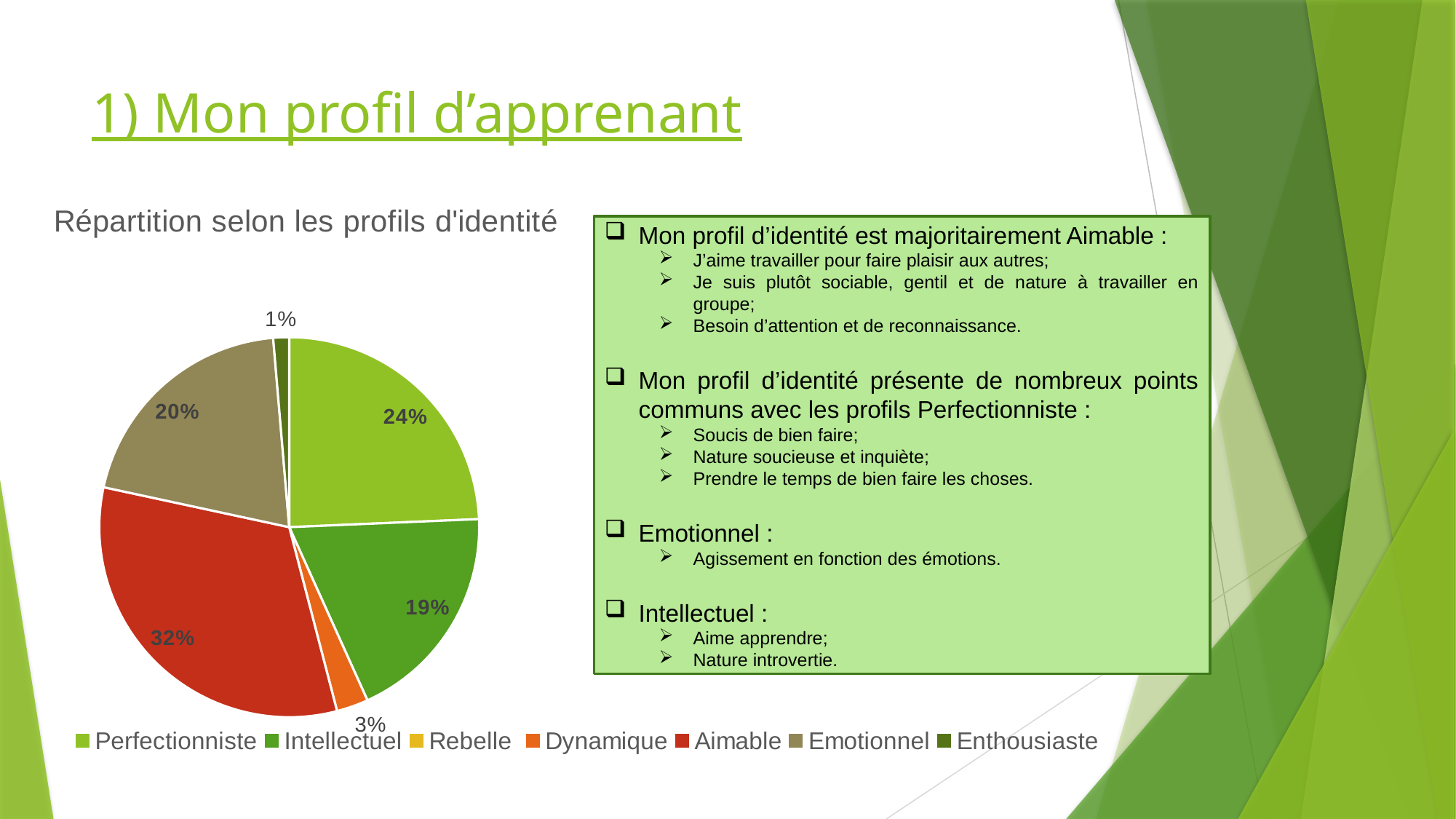
What percentage of the pie is Intellectuel? 19% What percentage of the pie is Aimable? 32% What percentage of the pie is Perfectionniste? 24% What is the difference in percentage points between Aimable and Perfectionniste? 8% How many entries does the chart legend list? 7 What type of chart is shown on the slide? pie chart Which is larger, the share for Perfectionniste or the share for Emotionnel? Perfectionniste Which profile has the largest share of the pie? Aimable What percentage of the pie is Dynamique? 3% What is the difference in percentage points between Emotionnel and Intellectuel? 1% What percentage of the pie is Emotionnel? 20% What is the title of the chart? Répartition selon les profils d'identité